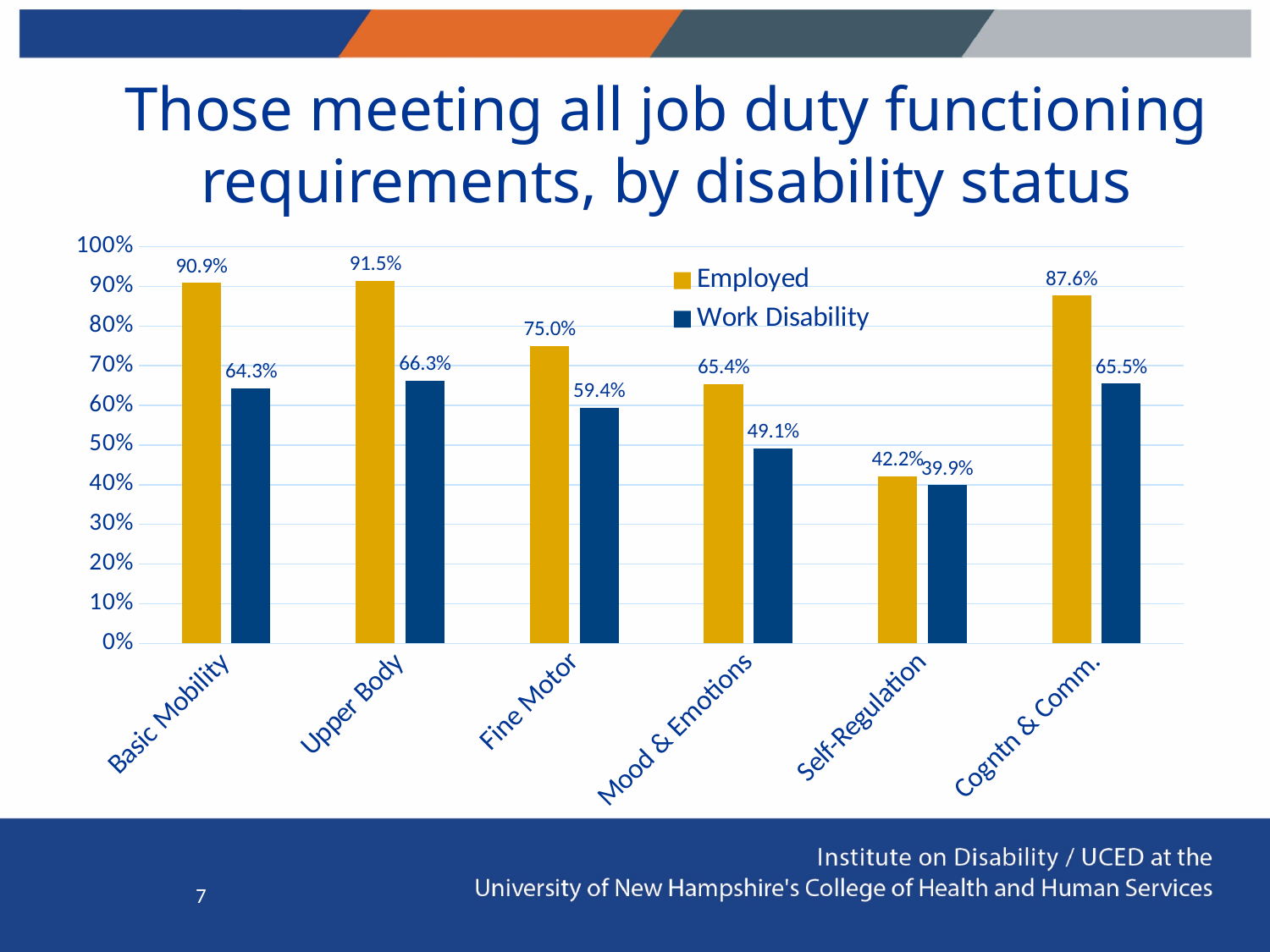
What is the difference between the Employed and Work Disability values for Cogntn & Comm.? 22.1% Which colour represents the Work Disability series? Dark blue Is the Work Disability value for Upper Body greater or less than 60%? greater What is the Work Disability value for Self-Regulation? 39.9% Which category has the lowest Work Disability value? Self-Regulation Which category has the highest Employed value? Upper Body How many series does the legend list? 2 What is the Employed value for Basic Mobility? 90.9% What kind of chart is shown on the slide? Bar chart What is the Work Disability value for Fine Motor? 59.4% Which is larger for Mood & Emotions: the Employed value or the Work Disability value? Employed How many categories are shown on the x axis? 6